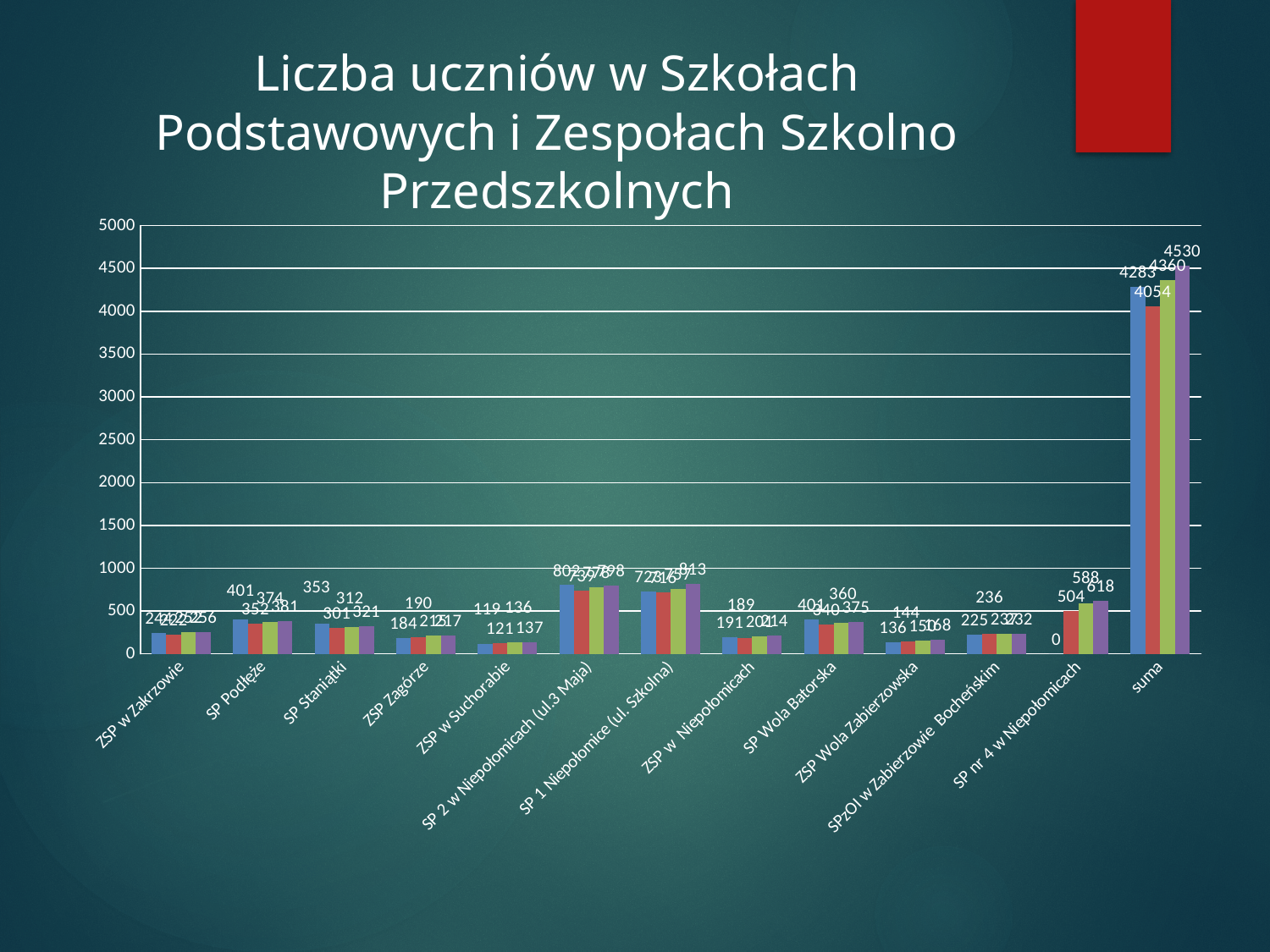
Is the value of the blue (first) bar for 'suma' greater or less than 4000? greater What is the value of the purple (fourth) bar for 'suma'? 4530 Excluding 'suma', which school has the lowest blue (first) bar? SP nr 4 w Niepołomicach What is the value of the blue (first) bar for 'SPzOI w Zabierzowie Bocheńskim'? 225 What is the value of the purple (fourth) bar for 'SP 1 Niepołomice (ul. Szkolna)'? 813 How many categories are shown along the x axis of the chart? 13 Which category has the highest bars in the chart? suma What is the difference between the purple (fourth) bar and the red (second) bar for 'suma'? 476 Is the purple (fourth) bar for 'SP Wola Batorska' larger or smaller than the purple (fourth) bar for 'ZSP Wola Zabierzowska'? larger What is the value of the blue (first) bar for 'SP nr 4 w Niepołomicach'? 0 What kind of chart is shown on the slide? bar chart What is the value of the red (second) bar for 'suma'? 4054